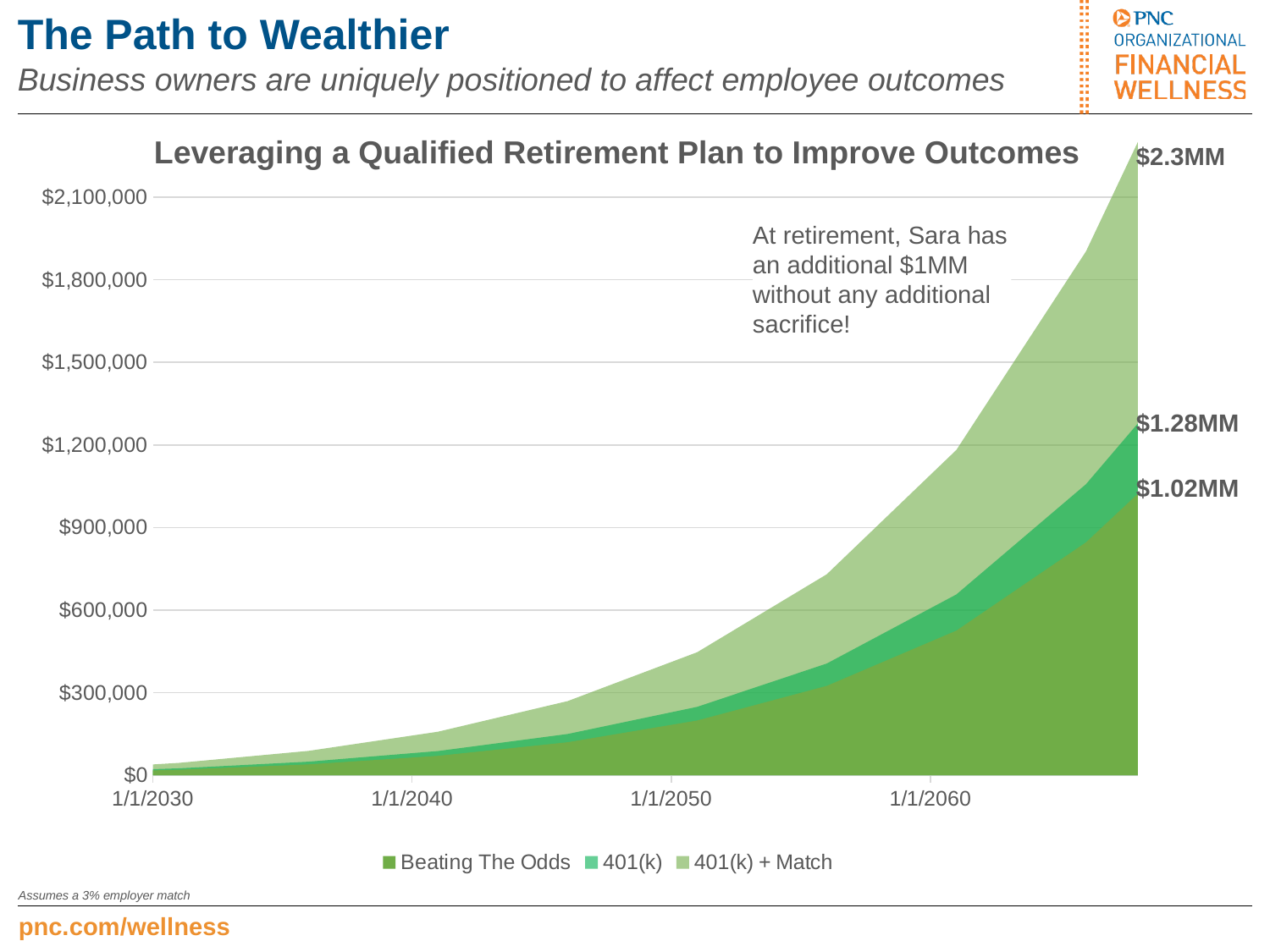
Which ends higher, the 401(k) series or the Beating The Odds series? 401(k) What type of chart is shown on the slide? Area chart What are the three series listed in the chart legend? Beating The Odds, 401(k), 401(k) + Match What is the final labeled value for the Beating The Odds series? $1.02MM Which series ends with the lowest value at retirement? Beating The Odds What is the final labeled value for the 401(k) + Match series? $2.3MM Which series ends with the highest value at retirement? 401(k) + Match What is the difference between the final values of the 401(k) + Match series and the 401(k) series? $1.02MM How many series does the chart legend list? 3 Do the values of the 401(k) + Match series rise or fall from 1/1/2030 to the end of the chart? Rise What is the final labeled value for the 401(k) series? $1.28MM What is the title of the chart? Leveraging a Qualified Retirement Plan to Improve Outcomes